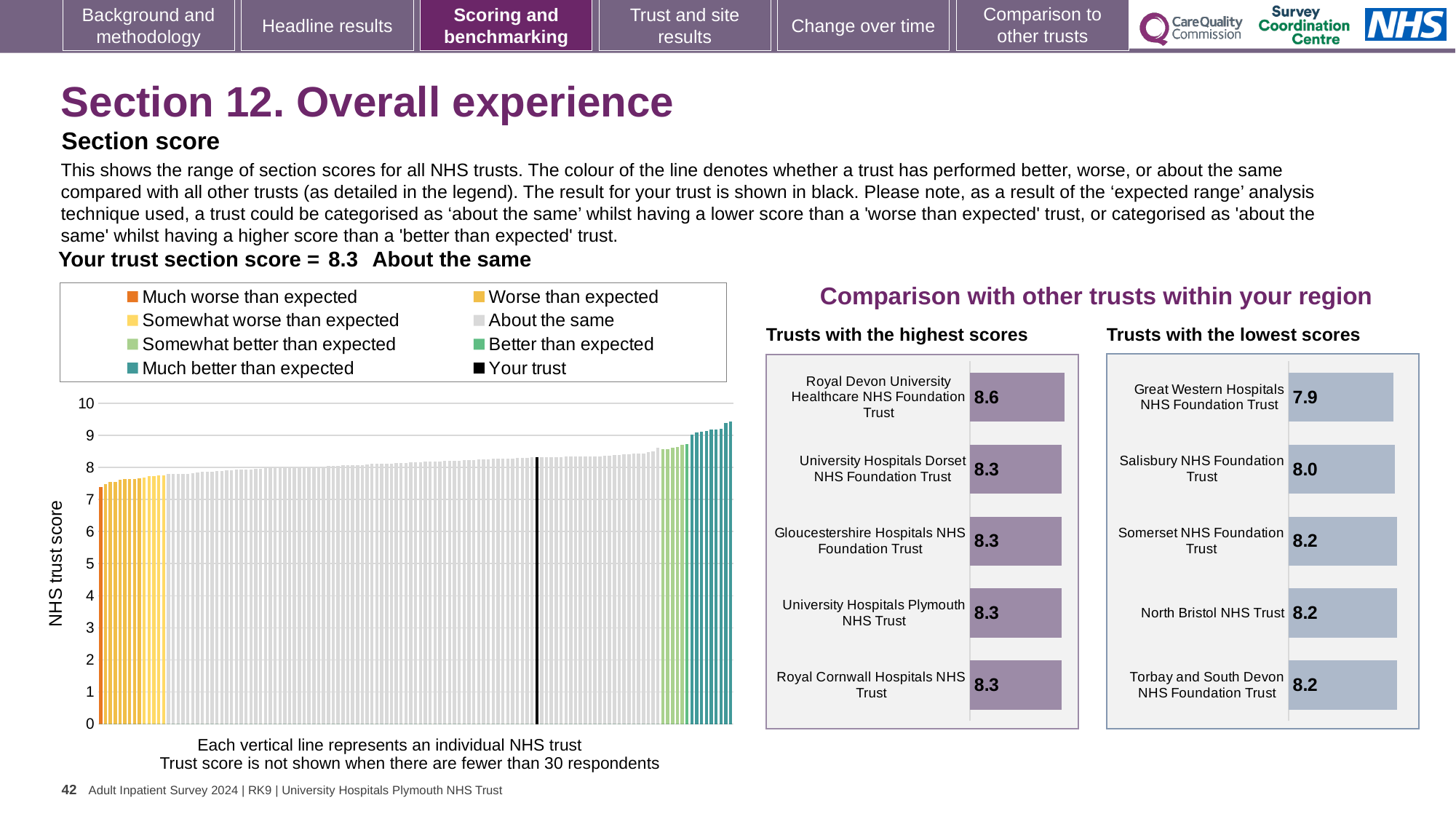
In the 'Trusts with the highest scores' chart, what is the difference between the scores of Royal Devon University Healthcare NHS Foundation Trust and University Hospitals Dorset NHS Foundation Trust? 0.3 In the main chart on the left showing all NHS trusts, is the value of the highest bar greater or less than 9? greater In the 'Trusts with the highest scores' chart, what is the score for Royal Devon University Healthcare NHS Foundation Trust? 8.6 How many entries does the legend of the main chart on the left list? 8 In the 'Trusts with the highest scores' chart, which trust has the highest score? Royal Devon University Healthcare NHS Foundation Trust In the 'Trusts with the lowest scores' chart, which has the larger score: Salisbury NHS Foundation Trust or Great Western Hospitals NHS Foundation Trust? Salisbury NHS Foundation Trust In the main chart on the left showing all NHS trusts, what is the section score for your trust (the black line)? 8.3 In the 'Trusts with the lowest scores' chart, which trust has the lowest score? Great Western Hospitals NHS Foundation Trust How many trusts are listed in the 'Trusts with the highest scores' chart? 5 In the main chart on the left showing all NHS trusts, do the values rise or fall from left to right? rise In the 'Trusts with the lowest scores' chart, what is the score for Great Western Hospitals NHS Foundation Trust? 7.9 In the 'Trusts with the lowest scores' chart, what is the score for Salisbury NHS Foundation Trust? 8.0